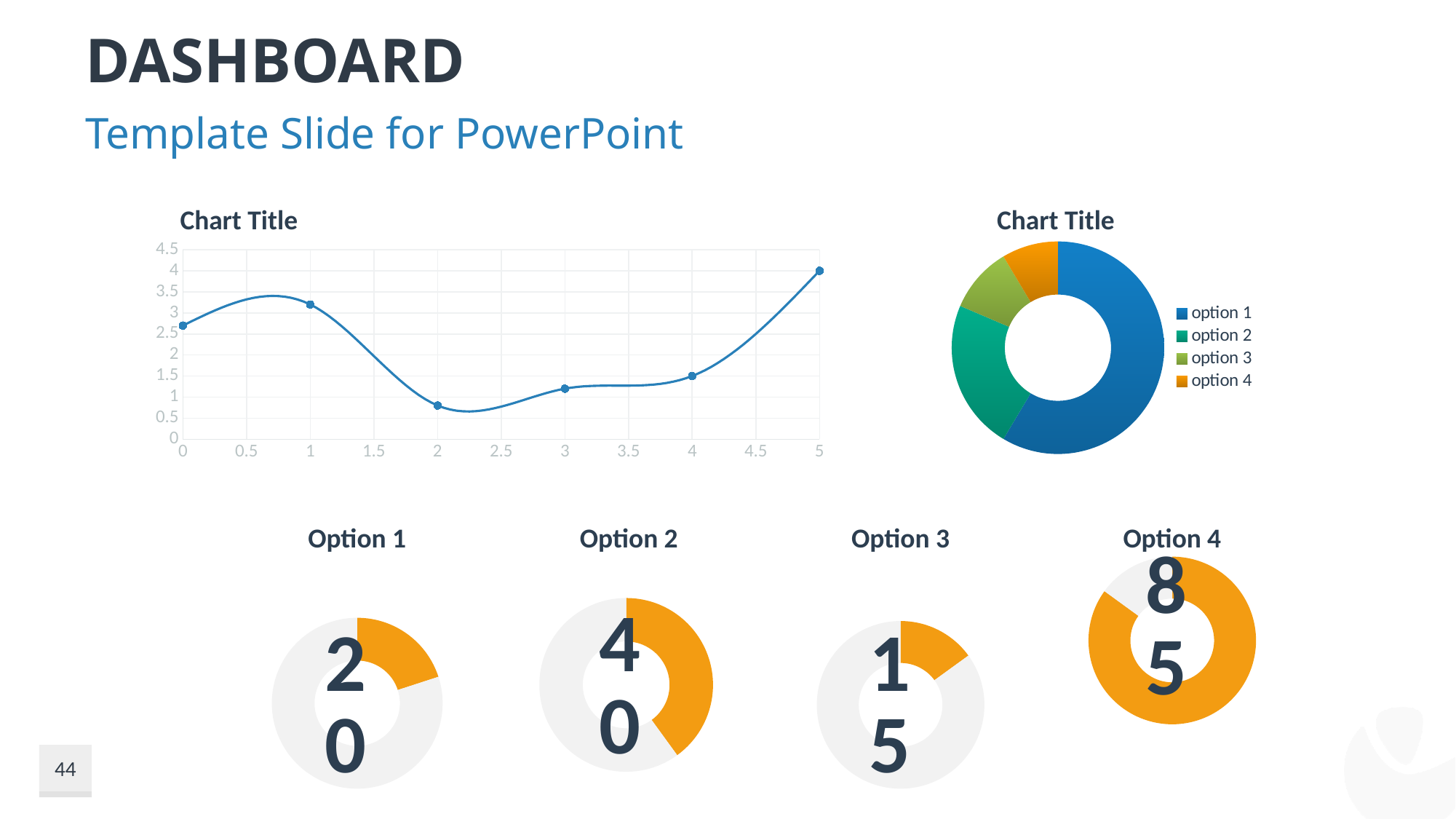
In the line chart on the left, at which x value is the plotted value lowest? 2 In the line chart on the left, at which x value is the plotted value highest? 5 In the line chart on the left, is the value at x = 1 greater or less than 2? greater In the line chart on the left, how many data points are plotted? 6 In the doughnut chart on the right, which option has the smallest slice? option 4 In the line chart on the left, is the value at x = 2 greater or less than 1? less How many entries does the legend of the doughnut chart on the right list? 4 In the doughnut chart on the right, which option has the largest slice? option 1 What type of chart is the chart on the right of the slide, next to the legend with option 1 to option 4? doughnut chart What type of chart is the chart on the left of the slide? line chart Among the four gauge charts at the bottom of the slide, which option shows the highest value? Option 4 In the line chart on the left, which is larger: the value at x = 0 or the value at x = 3? x = 0